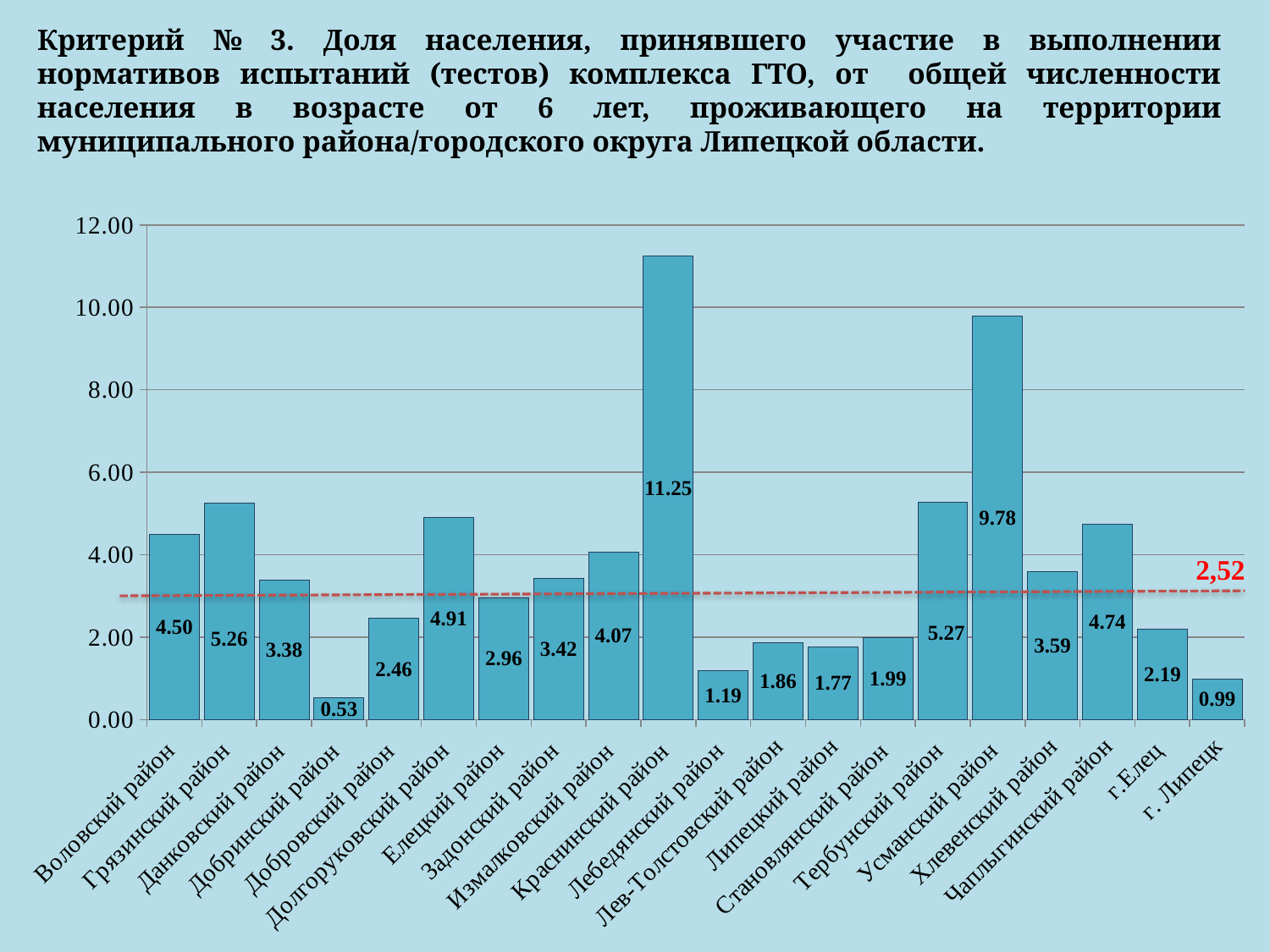
Which category has the highest value? Краснинский район Is the value for Усманский район greater or less than 8.00? greater How many categories are shown on the x axis? 20 What is the value for Краснинский район? 11.25 Which is larger, the value for Долгоруковский район or Чаплыгинский район? Долгоруковский район What is the difference between the values for Краснинский район and Усманский район? 1.47 What is the value for Добровский район? 2.46 What kind of chart is shown on the slide? bar chart What value is labelled on the red dashed horizontal line? 2,52 What is the value for г. Липецк? 0.99 Which category has the lowest value? Добринский район What is the difference between the values for Грязинский район and Воловский район? 0.76